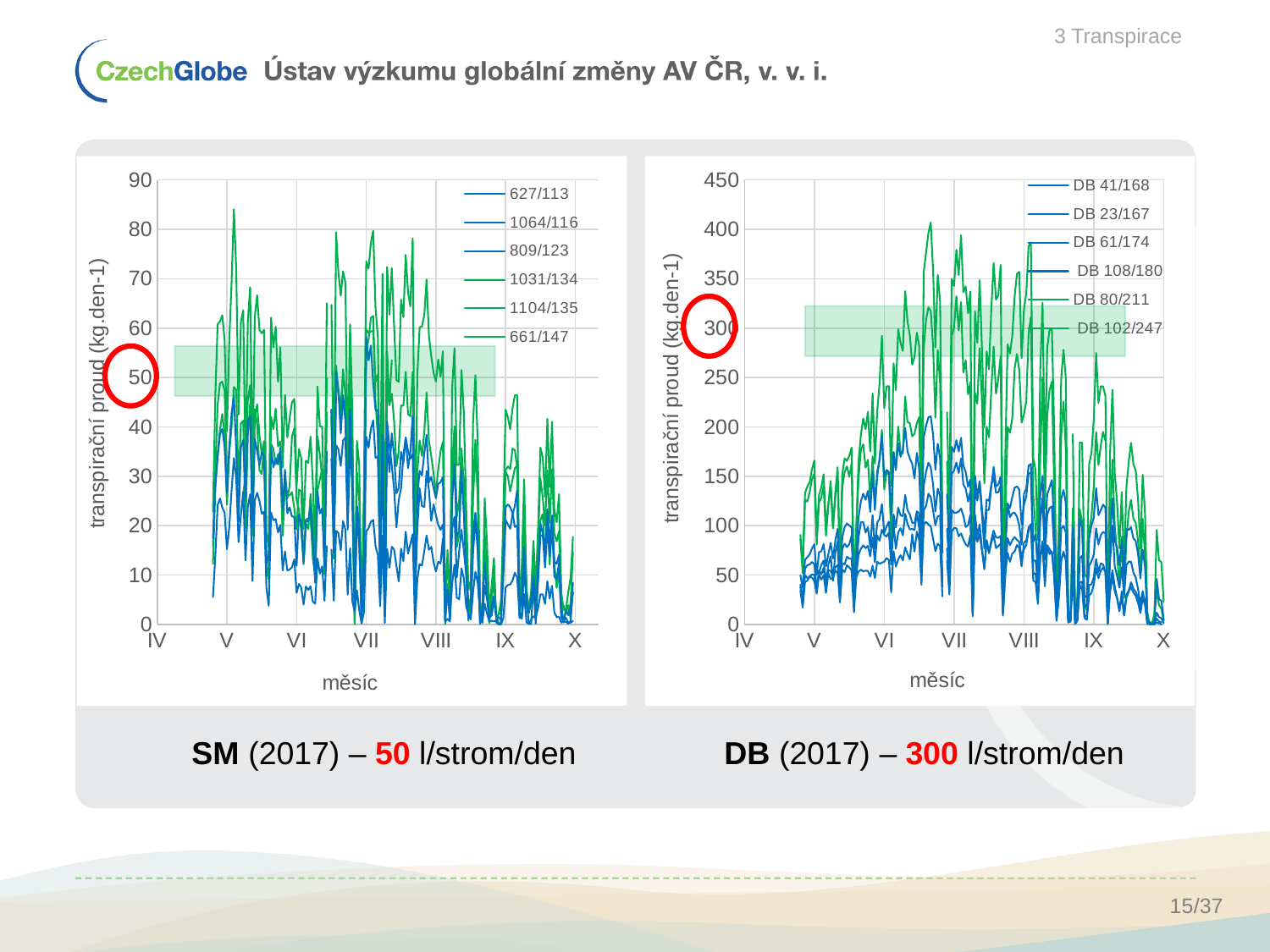
How many month labels are shown on the x axis of the left chart (SM 2017)? 7 How many series does the legend of the left chart (SM 2017) list? 6 In the right chart (DB 2017), what is the label of the last series in the legend? DB 102/247 In the right chart (DB 2017), is the highest peak of the blue lines greater or less than 250? less In the right chart (DB 2017), what is the maximum value shown on the y axis? 450 In the left chart (SM 2017), what is the maximum value shown on the y axis? 90 In the left chart (SM 2017), what is the label of the first series in the legend? 627/113 In the left chart (SM 2017), is the highest peak of the blue lines greater or less than 70? less How many series does the legend of the right chart (DB 2017) list? 6 In the right chart (DB 2017), is the highest peak of the green lines greater or less than 350? greater What kind of chart is the right chart (DB 2017)? line chart What kind of chart is the left chart (SM 2017)? line chart